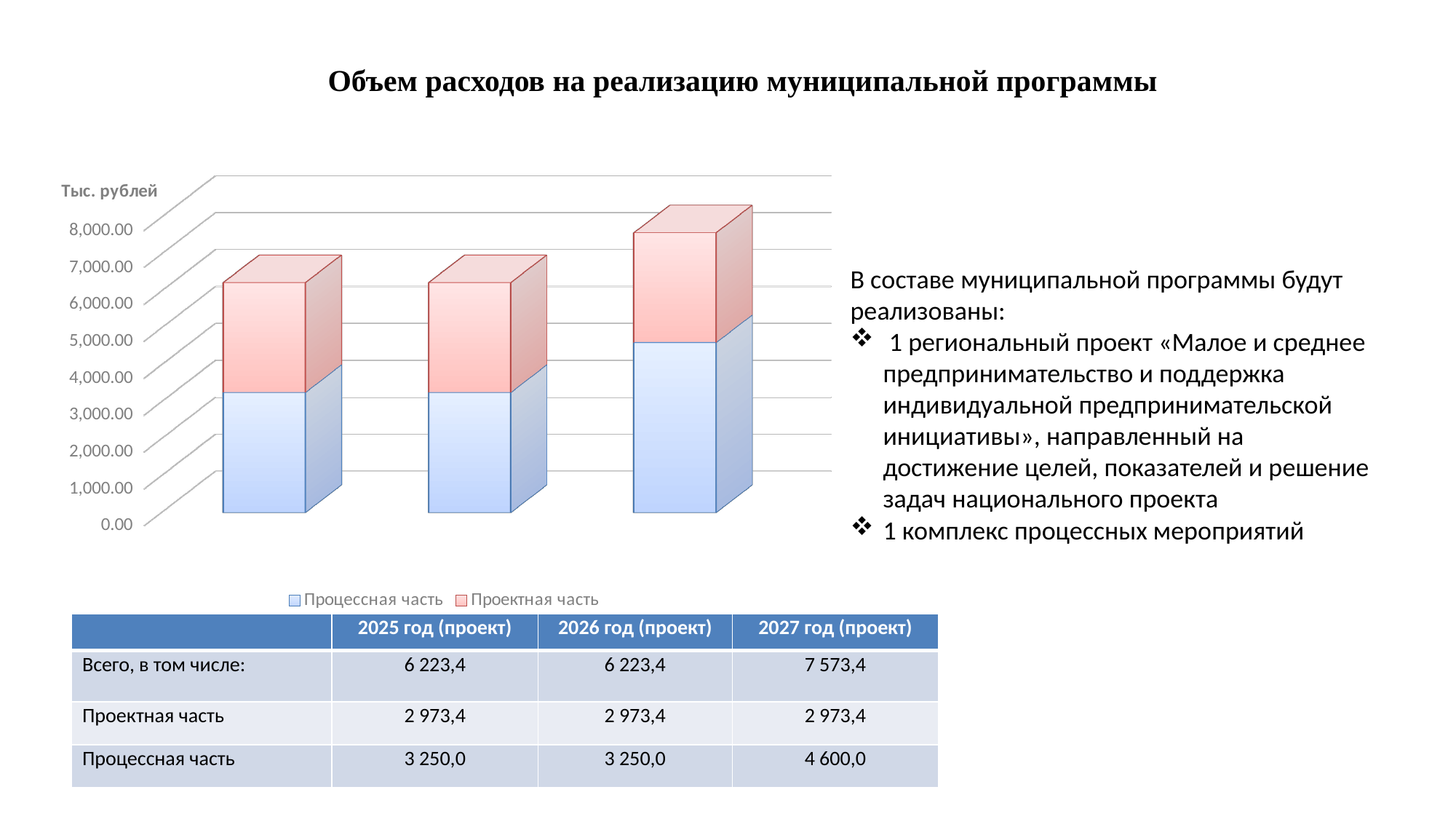
Do the bar totals rise or fall from the leftmost bar to the rightmost bar? rise According to the table under the chart, what is the value of Процессная часть for 2027 год (проект)? 4 600,0 What kind of chart is shown on the slide? bar chart What are the two series named in the chart legend? Процессная часть, Проектная часть Is the total height of the rightmost bar greater or less than 7,000.00? greater How many series does the chart legend list? 2 According to the table under the chart, what is the difference between the total (Всего) for 2027 год (проект) and for 2025 год (проект)? 1 350,0 Is the blue (Процессная часть) segment of the rightmost bar greater or less than 4,000.00? greater How many stacked bars are plotted in the chart? 3 What unit label is shown at the top of the vertical axis? Тыс. рублей Is the total height of the leftmost bar greater or less than 7,000.00? less Which bar has the largest total: the leftmost, middle or rightmost? rightmost